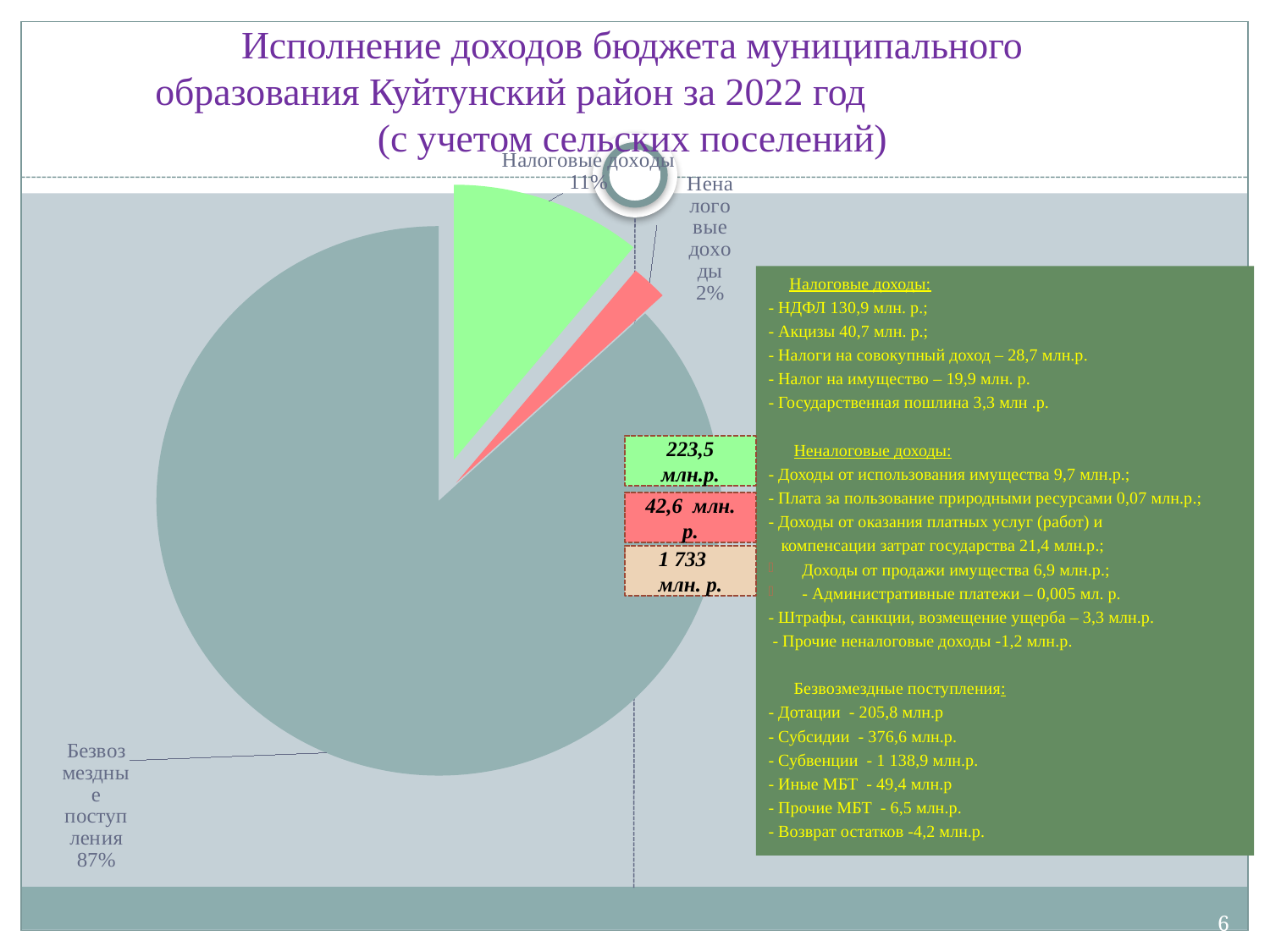
What value is printed in the green box next to the pie chart? 223,5 млн.р. Which category has the largest slice of the pie? Безвозмездные поступления How many slices does the pie chart have? 3 What value is printed in the red box next to the pie chart? 42,6 млн. р. Which is larger, the share for Налоговые доходы or the share for Неналоговые доходы? Налоговые доходы What is the difference in percentage points between the Безвозмездные поступления share and the Налоговые доходы share? 76 What is the difference in percentage points between the Налоговые доходы share and the Неналоговые доходы share? 9 What share of the pie does Безвозмездные поступления represent? 87% Which category has the smallest slice of the pie? Неналоговые доходы What share of the pie does Налоговые доходы represent? 11% What type of chart is shown on the slide? pie chart What share of the pie does Неналоговые доходы represent? 2%